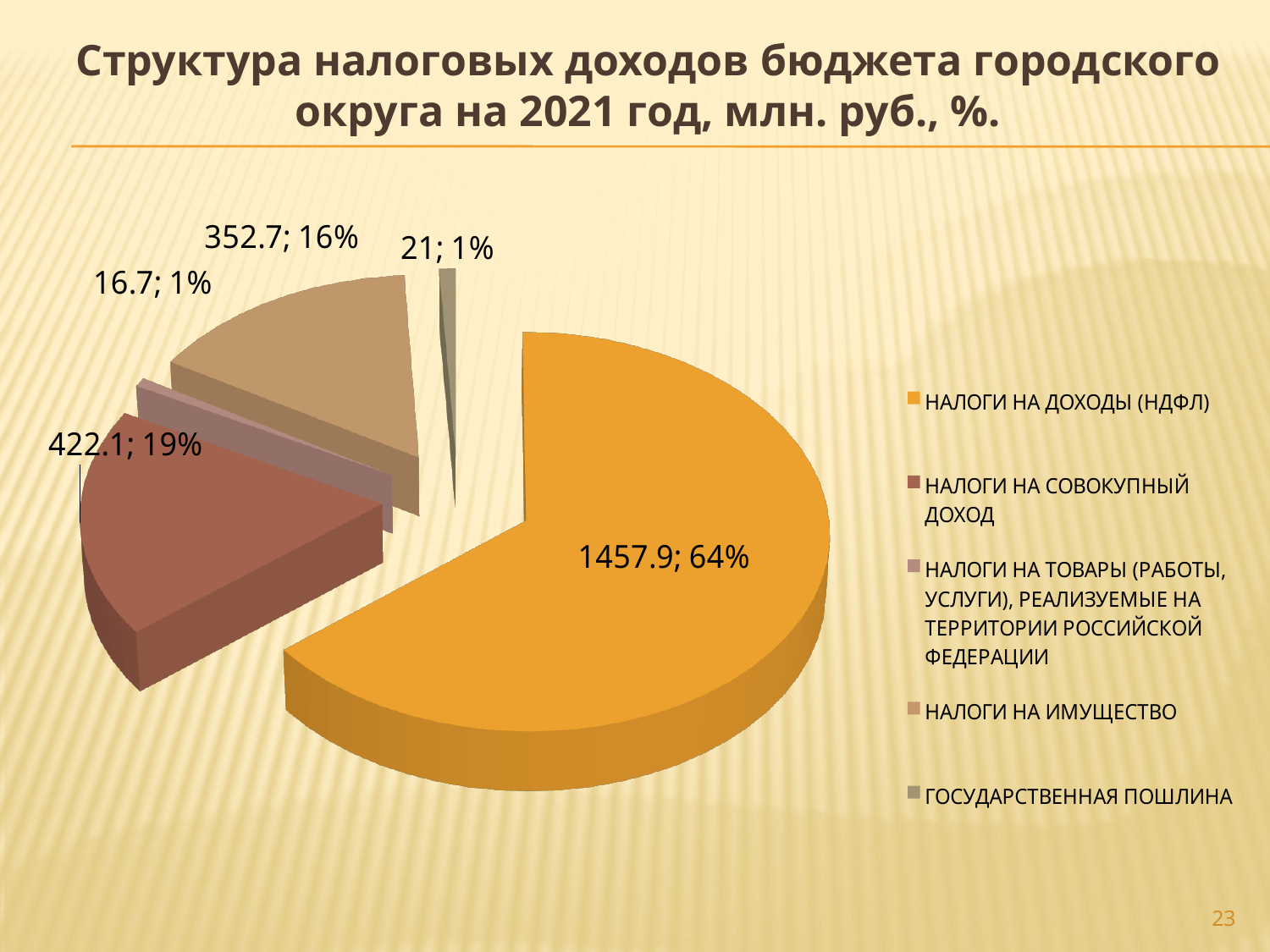
What share of the pie does НАЛОГИ НА ДОХОДЫ (НДФЛ) represent? 64% What is the difference between the values for НАЛОГИ НА СОВОКУПНЫЙ ДОХОД and НАЛОГИ НА ИМУЩЕСТВО? 69.4 What is the value for ГОСУДАРСТВЕННАЯ ПОШЛИНА? 21 How many categories does the legend list? 5 What share of the pie does НАЛОГИ НА ИМУЩЕСТВО represent? 16% Which category has the smallest value? НАЛОГИ НА ТОВАРЫ (РАБОТЫ, УСЛУГИ), РЕАЛИЗУЕМЫЕ НА ТЕРРИТОРИИ РОССИЙСКОЙ ФЕДЕРАЦИИ What is the value for НАЛОГИ НА ДОХОДЫ (НДФЛ)? 1457.9 Which is larger, the value for НАЛОГИ НА СОВОКУПНЫЙ ДОХОД or the value for НАЛОГИ НА ИМУЩЕСТВО? НАЛОГИ НА СОВОКУПНЫЙ ДОХОД What is the value for НАЛОГИ НА ИМУЩЕСТВО? 352.7 Which category has the largest slice of the pie? НАЛОГИ НА ДОХОДЫ (НДФЛ) What kind of chart is shown on the slide? pie chart What is the value for НАЛОГИ НА СОВОКУПНЫЙ ДОХОД? 422.1